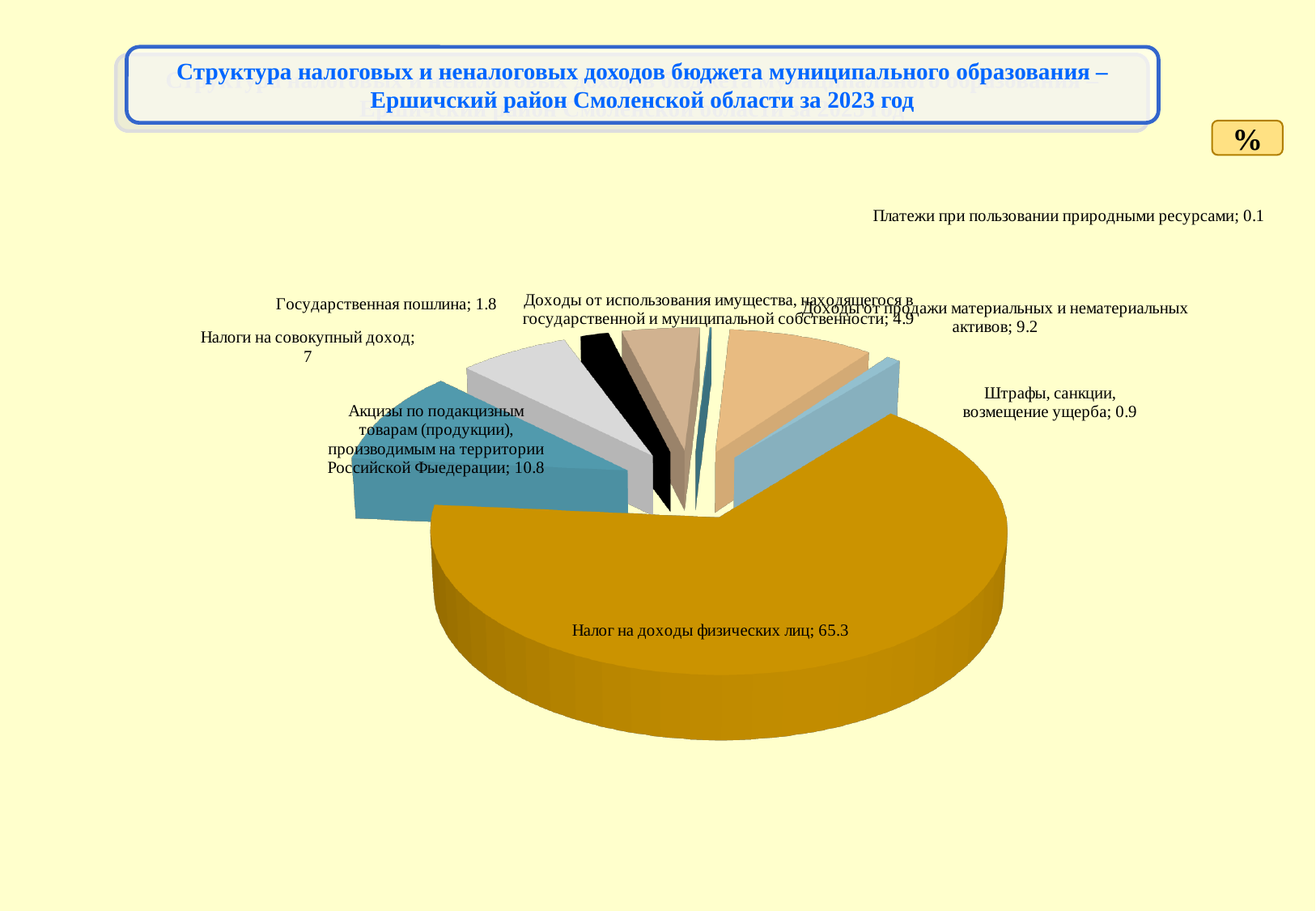
What is the value for Акцизы по подакцизным товарам (продукции), производимым на территории Российской Фыедерации? 10.8 Which is larger: Государственная пошлина or Доходы от использования имущества, находящегося в государственной и муниципальной собственности? Доходы от использования имущества, находящегося в государственной и муниципальной собственности What is the value for Налоги на совокупный доход? 7 What is the value for Штрафы, санкции, возмещение ущерба? 0.9 Which category has the smallest slice of the pie? Платежи при пользовании природными ресурсами Which category has the largest slice of the pie? Налог на доходы физических лиц What kind of chart is shown on the slide? pie chart How many categories are shown in the pie chart? 8 What is the value for Доходы от продажи материальных и нематериальных активов? 9.2 For which year does the chart title say the budget revenue structure is shown? 2023 What is the value for Налог на доходы физических лиц? 65.3 What is the difference between the values for Акцизы по подакцизным товарам and Налоги на совокупный доход? 3.8